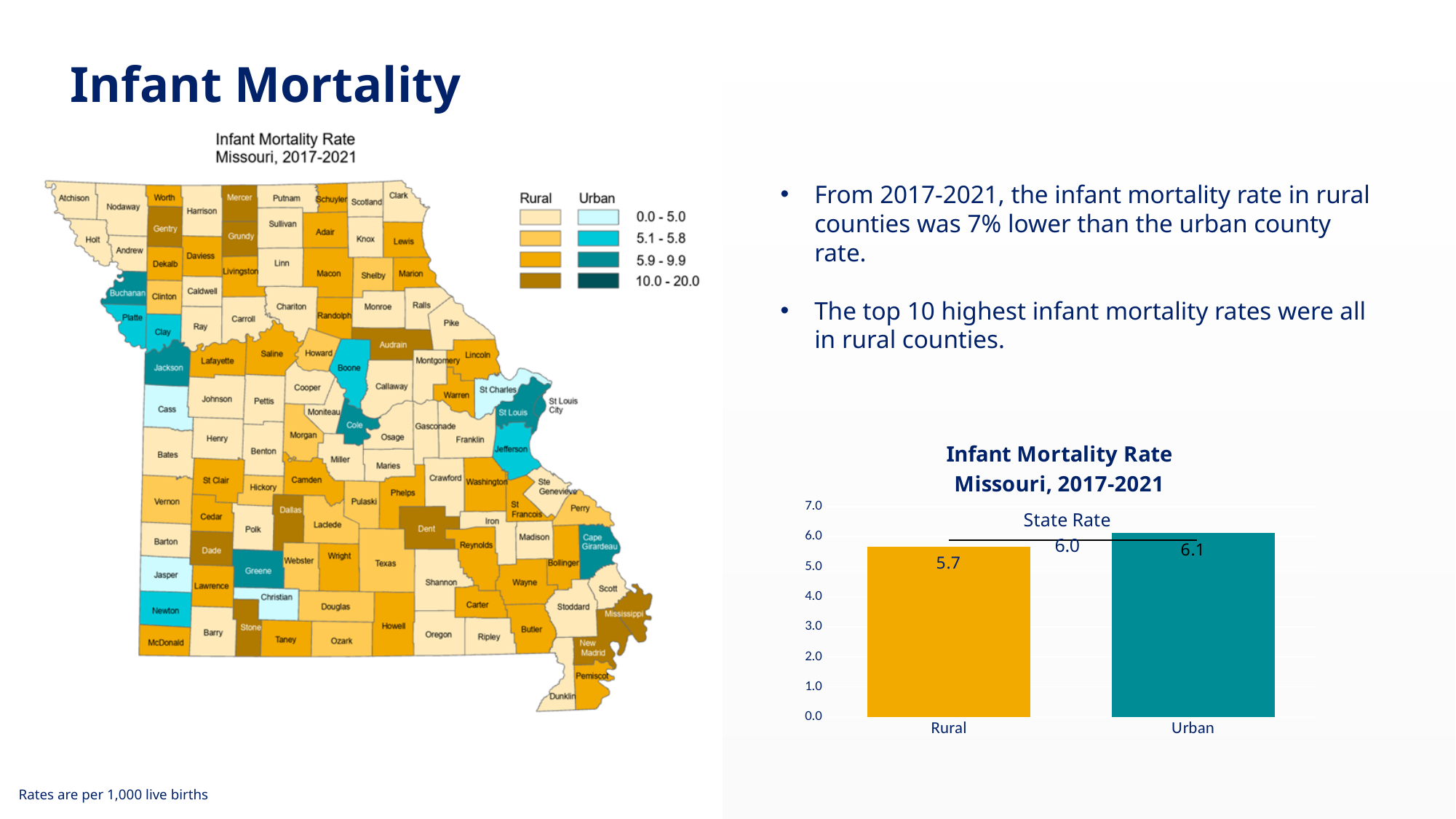
What is the title of the bar chart on the right of the slide? Infant Mortality Rate Missouri, 2017-2021 In the bar chart, which category has the lowest infant mortality rate? Rural In the bar chart, which category has the higher infant mortality rate, Rural or Urban? Urban In the bar chart, what is the infant mortality rate for Rural? 5.7 In the bar chart, is the value for Rural greater or less than 6.0? less In the bar chart, what is the difference between the Urban and Rural infant mortality rates? 0.4 In the bar chart, what is the State Rate shown by the horizontal line? 6.0 In the bar chart, what colour is the Urban bar? teal In the bar chart, is the value for Urban greater or less than 5.0? greater In the bar chart, what is the infant mortality rate for Urban? 6.1 What kind of chart is the Infant Mortality Rate chart on the right of the slide? bar chart In the bar chart, how many categories are plotted? 2